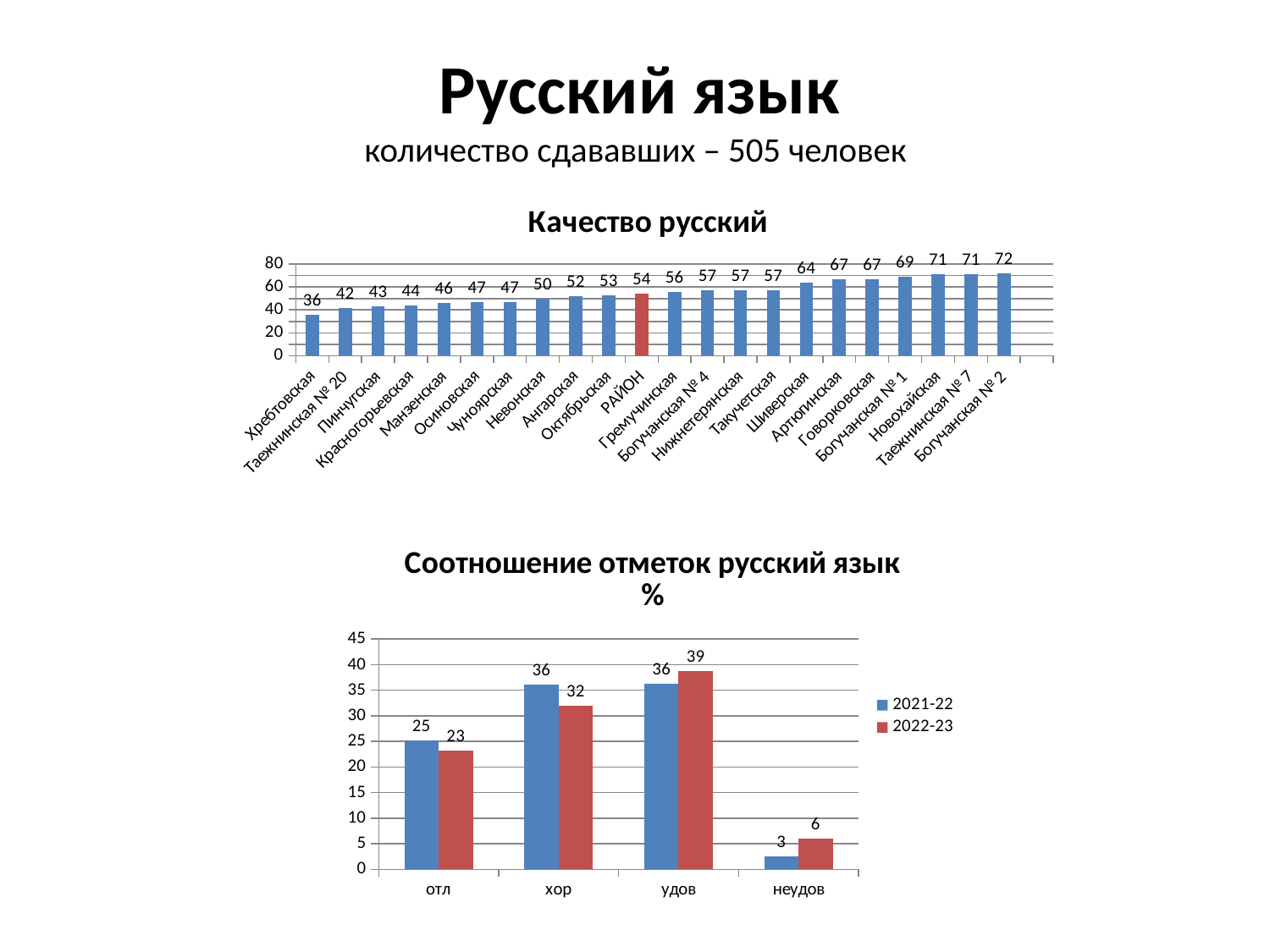
In the chart 'Соотношение отметок русский язык %', what is the difference between the 2022-23 and 2021-22 values for неудов? 3 In the chart 'Качество русский', what is the difference between the values for Богучанская № 2 and Хребтовская? 36 In the chart 'Соотношение отметок русский язык %', what is the value for удов in 2022-23? 39 In the chart 'Качество русский', what is the value for РАЙОН? 54 In the chart 'Качество русский', how many categories are shown on the x axis? 22 How many series does the legend of the chart 'Соотношение отметок русский язык %' list? 2 In the chart 'Качество русский', which category has the highest value? Богучанская № 2 In the chart 'Качество русский', which category has the lowest value? Хребтовская In the chart 'Качество русский', what is the value for Хребтовская? 36 In the chart 'Соотношение отметок русский язык %', which is larger for хор: 2021-22 or 2022-23? 2021-22 In the chart 'Качество русский', do the values rise or fall from left to right along the x axis? rise In the chart 'Качество русский', which bar is coloured differently from the others? РАЙОН